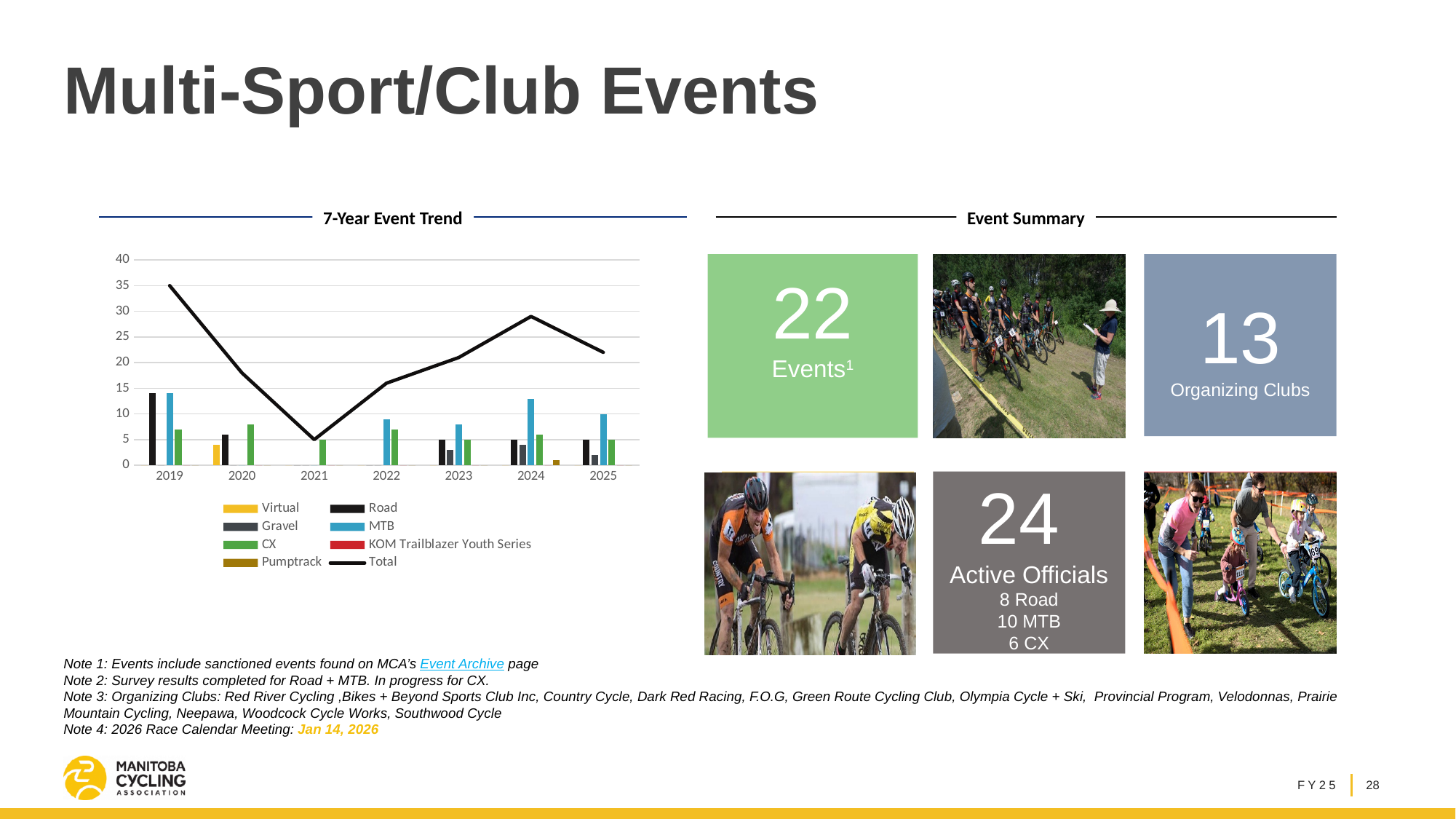
In the 7-Year Event Trend chart, is the MTB value for 2024 greater or less than 10? greater How many years are shown on the x axis of the 7-Year Event Trend chart? 7 In the 7-Year Event Trend chart, which series is drawn as a line rather than bars? Total In the 7-Year Event Trend chart, is the Total for 2024 greater or less than 25? greater In the 7-Year Event Trend chart, which year has the highest Total? 2019 In the 7-Year Event Trend chart, which year has the lowest Total? 2021 In the 7-Year Event Trend chart, which is larger: the Road value for 2019 or the Road value for 2025? 2019 What kind of chart is the 7-Year Event Trend chart? bar chart with a line In the 7-Year Event Trend chart, is the Total for 2022 greater or less than 20? less In the 7-Year Event Trend chart, which is larger: the Total for 2024 or the Total for 2025? 2024 How many series does the legend of the 7-Year Event Trend chart list? 8